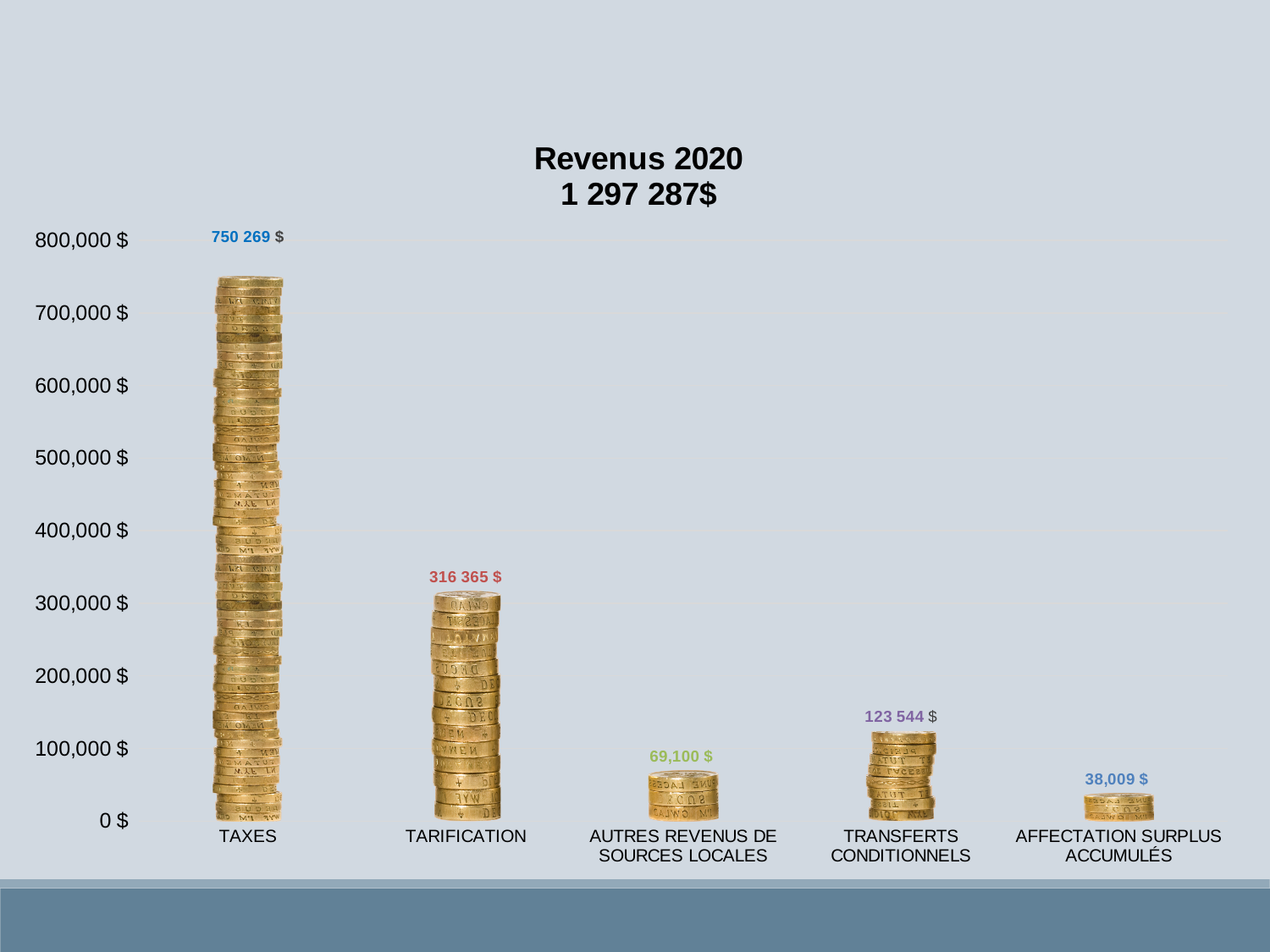
What is the value for TARIFICATION? 316 365 $ What is the value for TAXES? 750 269 $ Which is larger, TRANSFERTS CONDITIONNELS or AUTRES REVENUS DE SOURCES LOCALES? TRANSFERTS CONDITIONNELS What is the value for AFFECTATION SURPLUS ACCUMULÉS? 38,009 $ What kind of chart is this? Bar chart How many categories are shown on the chart? 5 Which category has the lowest value? AFFECTATION SURPLUS ACCUMULÉS What is the difference between the values for TAXES and TARIFICATION? 433 904 $ What is the value for TRANSFERTS CONDITIONNELS? 123 544 $ What is the value for AUTRES REVENUS DE SOURCES LOCALES? 69,100 $ Which category has the highest value? TAXES What total amount is shown in the chart title? 1 297 287$